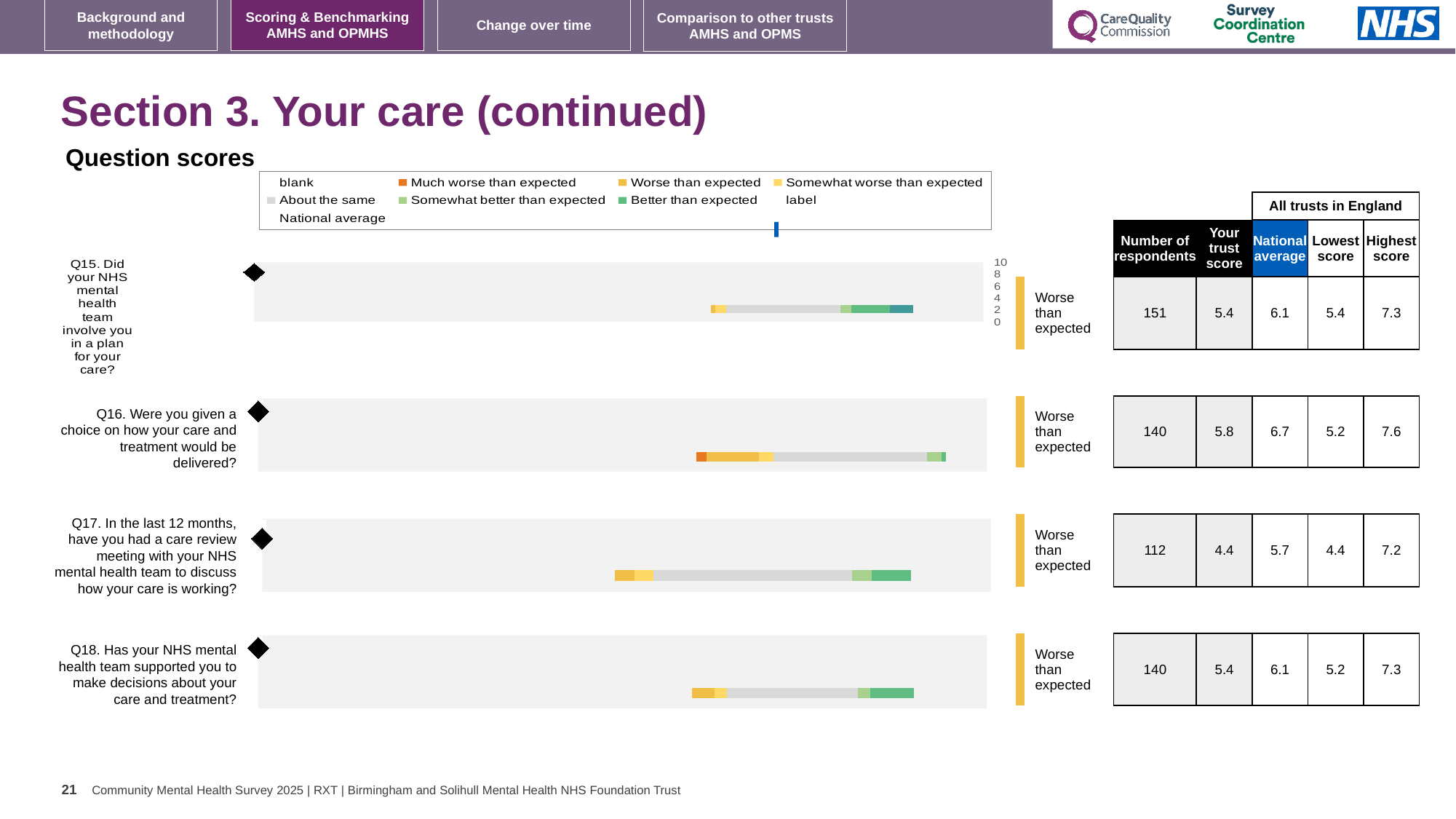
For Q15, which is larger: the trust score or the national average? National average How many questions (Q15 to Q18) are plotted in the question scores chart? 4 What kind of chart is used to show the question scores on this slide? bar chart Which question has the lowest 'Your trust score' on this slide? Q17 What is the national average score for Q16 (Were you given a choice on how your care and treatment would be delivered?)? 6.7 What is the lowest score among all trusts in England for Q17? 4.4 What is the highest score among all trusts in England for Q18 (supported you to make decisions about your care and treatment)? 7.3 What is the 'Your trust score' for Q15 (Did your NHS mental health team involve you in a plan for your care?)? 5.4 Which question has the highest 'Your trust score' on this slide? Q16 What benchmark label is shown next to each of the four question bars? Worse than expected What is the difference between the national average and the trust score for Q16? 0.9 How many respondents answered Q17 (care review meeting in the last 12 months)? 112